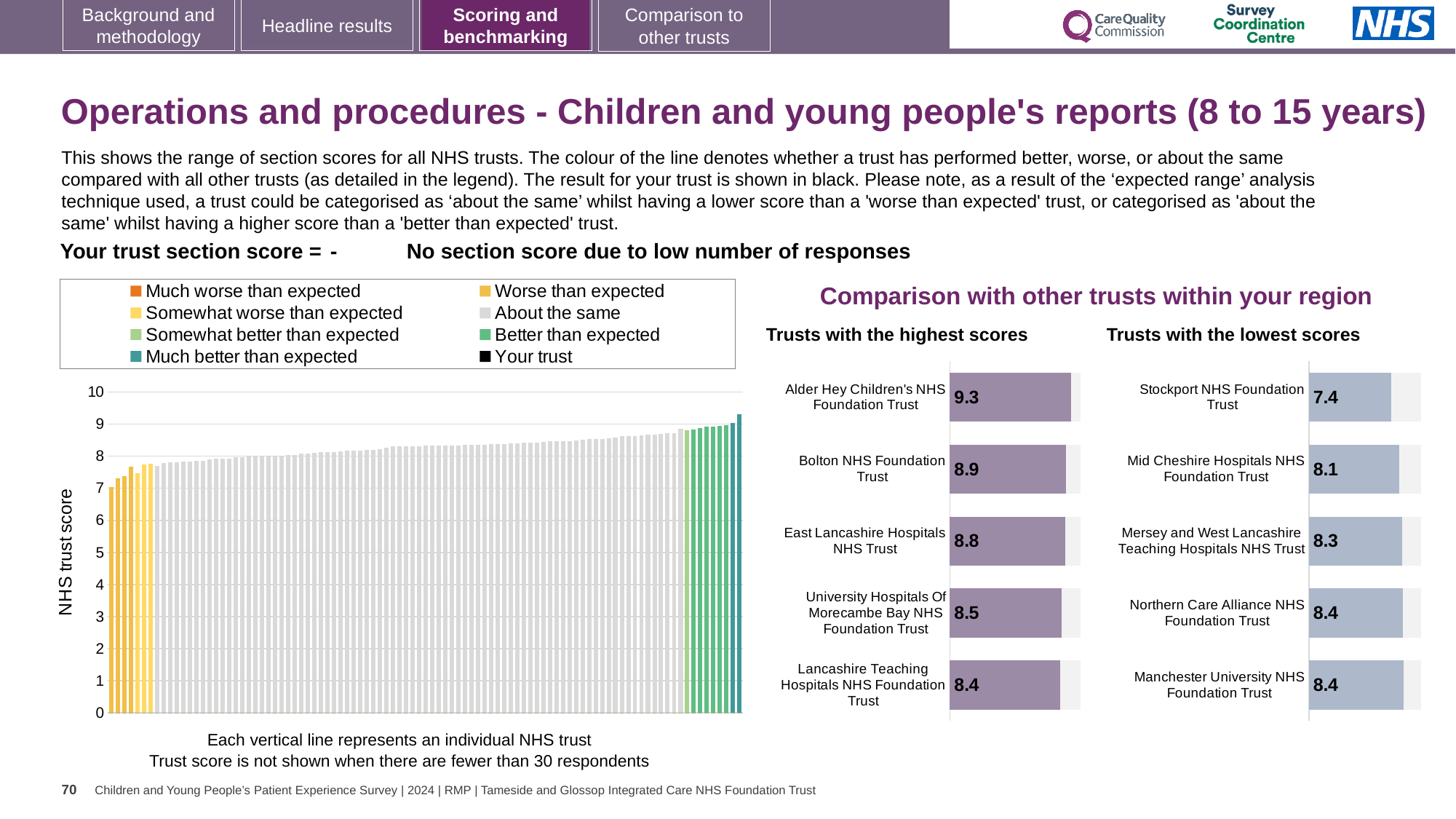
In the 'Trusts with the lowest scores' chart, which trust has the lowest score? Stockport NHS Foundation Trust How many entries does the legend above the 'NHS trust score' chart list? 8 In the 'Trusts with the highest scores' chart, which trust has the highest score? Alder Hey Children's NHS Foundation Trust In the 'Trusts with the highest scores' chart, what is the difference between the scores of Alder Hey Children's NHS Foundation Trust and Bolton NHS Foundation Trust? 0.4 In the 'Trusts with the lowest scores' chart, how much higher is Mid Cheshire Hospitals NHS Foundation Trust's score than Stockport NHS Foundation Trust's score? 0.7 Which has the higher score: East Lancashire Hospitals NHS Trust in the highest scores chart or Mersey and West Lancashire Teaching Hospitals NHS Trust in the lowest scores chart? East Lancashire Hospitals NHS Trust What type of chart is the large 'NHS trust score' chart on the left of the slide? Bar chart How many trusts are shown in the 'Trusts with the highest scores' chart? 5 In the 'NHS trust score' chart on the left, do the bar values rise or fall from left to right? Rise In the 'Trusts with the highest scores' chart, what is the score for Alder Hey Children's NHS Foundation Trust? 9.3 In the 'NHS trust score' chart on the left, is the value of the lowest bar greater or less than 8? less In the 'Trusts with the lowest scores' chart, what is the score for Stockport NHS Foundation Trust? 7.4